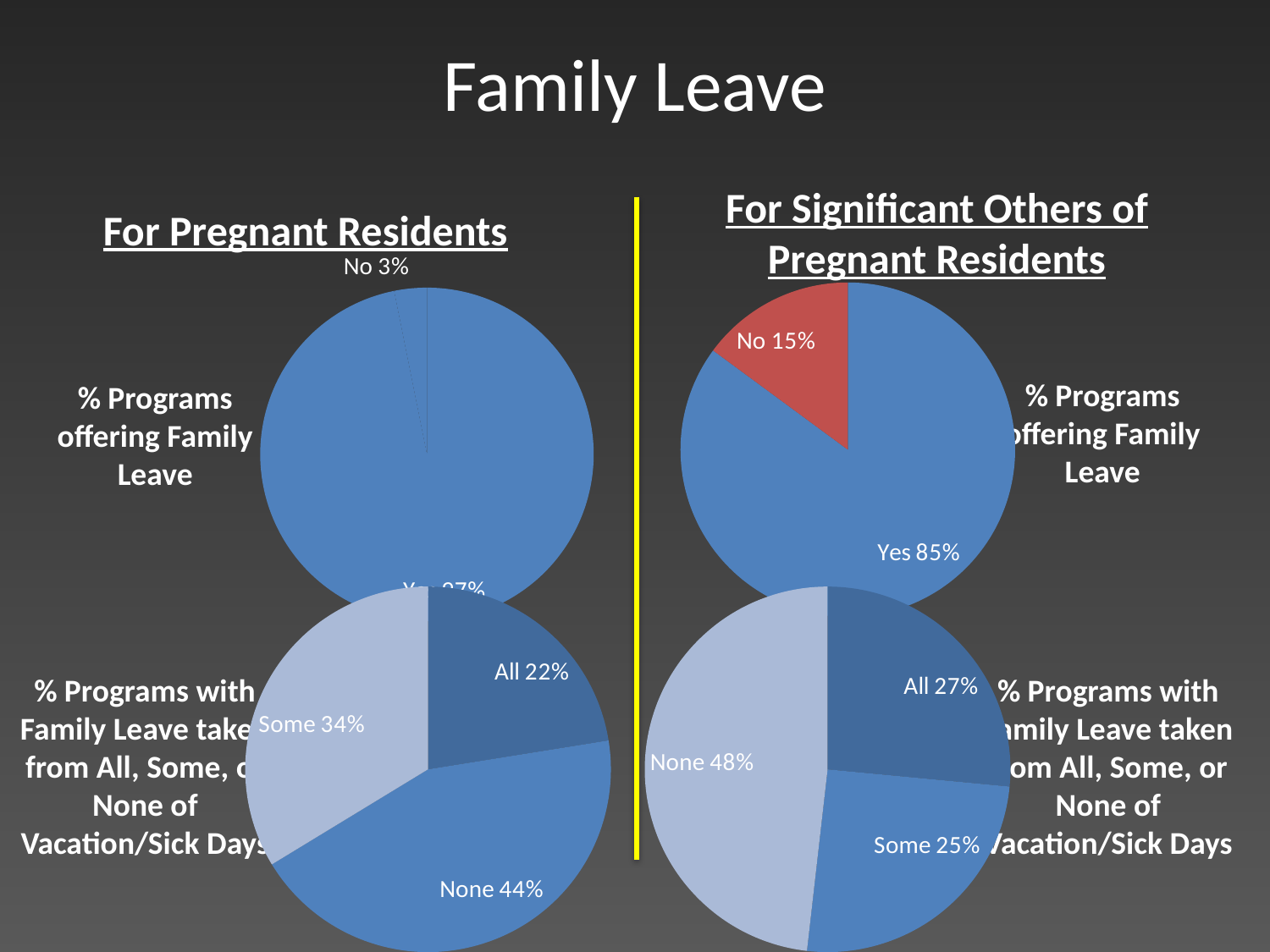
In the bottom-left pie chart (Family Leave taken from Vacation/Sick Days for Pregnant Residents), which category has the largest slice? None In the top-right pie chart (% Programs offering Family Leave for Significant Others of Pregnant Residents), what percentage is labelled "Yes"? 85% What type of chart is used for the top-right chart (% Programs offering Family Leave for Significant Others)? Pie chart How many slices does the bottom-left pie chart (Family Leave taken from Vacation/Sick Days for Pregnant Residents) have? 3 In the bottom-left pie chart (Family Leave taken from Vacation/Sick Days for Pregnant Residents), what is the difference in percentage points between "None" and "All"? 22 percentage points In the bottom-left pie chart (Family Leave taken from Vacation/Sick Days for Pregnant Residents), what percentage is labelled "None"? 44% In the top-left pie chart (% Programs offering Family Leave for Pregnant Residents), what percentage is labelled "No"? 3% In the bottom-right pie chart (Family Leave taken from Vacation/Sick Days for Significant Others), what percentage is labelled "All"? 27% In the bottom-right pie chart (Family Leave taken from Vacation/Sick Days for Significant Others), which category has the largest slice? None In the top-right pie chart (% Programs offering Family Leave for Significant Others of Pregnant Residents), what percentage is labelled "No"? 15% In the bottom-left pie chart (Family Leave taken from Vacation/Sick Days for Pregnant Residents), which category has the smallest slice? All In the top-right pie chart (% Programs offering Family Leave for Significant Others), what is the difference in percentage points between "Yes" and "No"? 70 percentage points